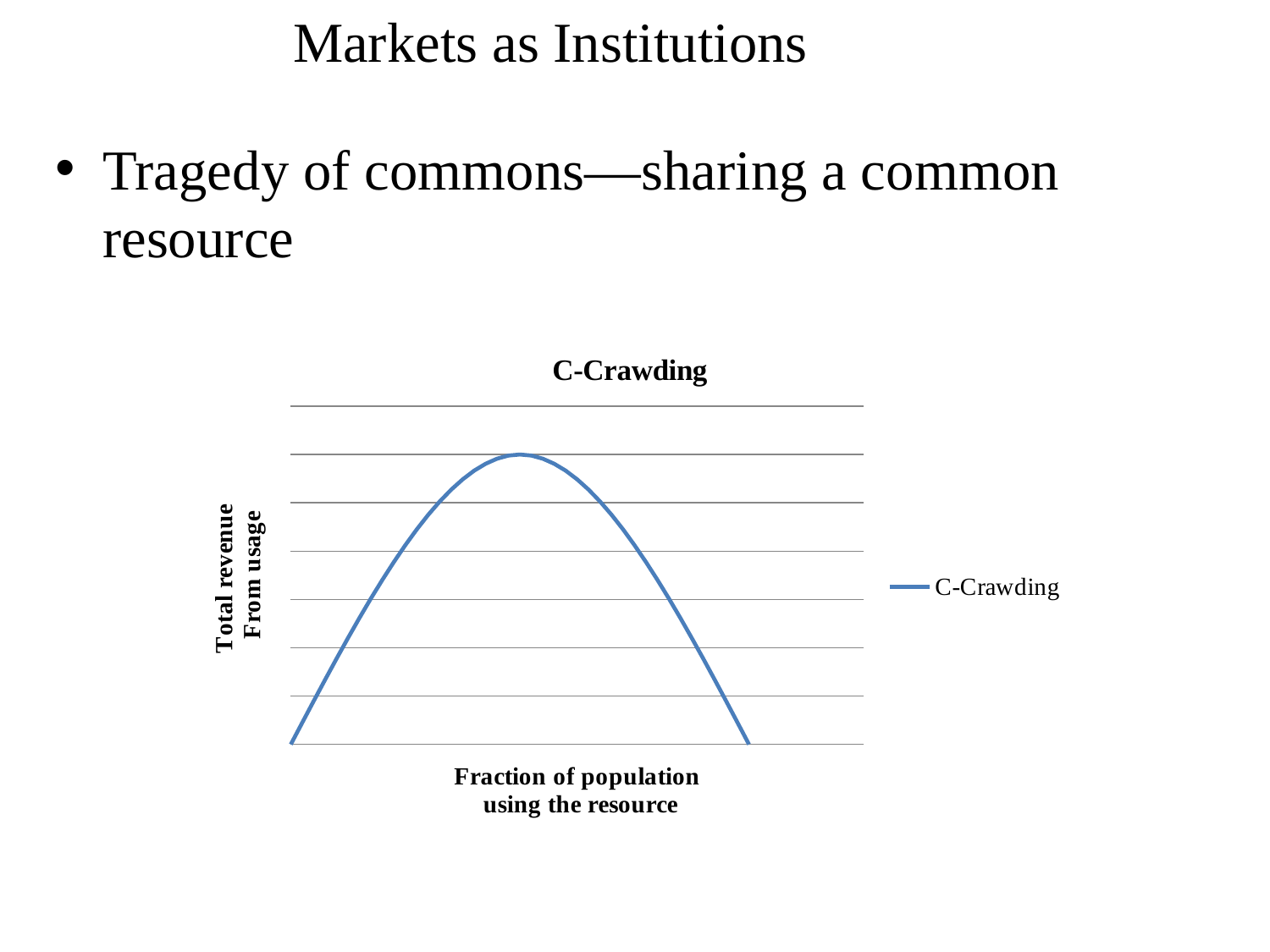
Does the line fall or rise over the right half of the chart? falls What kind of chart is shown on the slide? line chart What is the title of the chart? C-Crawding Does the plotted line rise or fall as the fraction of population using the resource increases from the left edge of the chart? rises, then falls What is the label on the x axis of the chart? Fraction of population using the resource How many series does the chart's legend list? 1